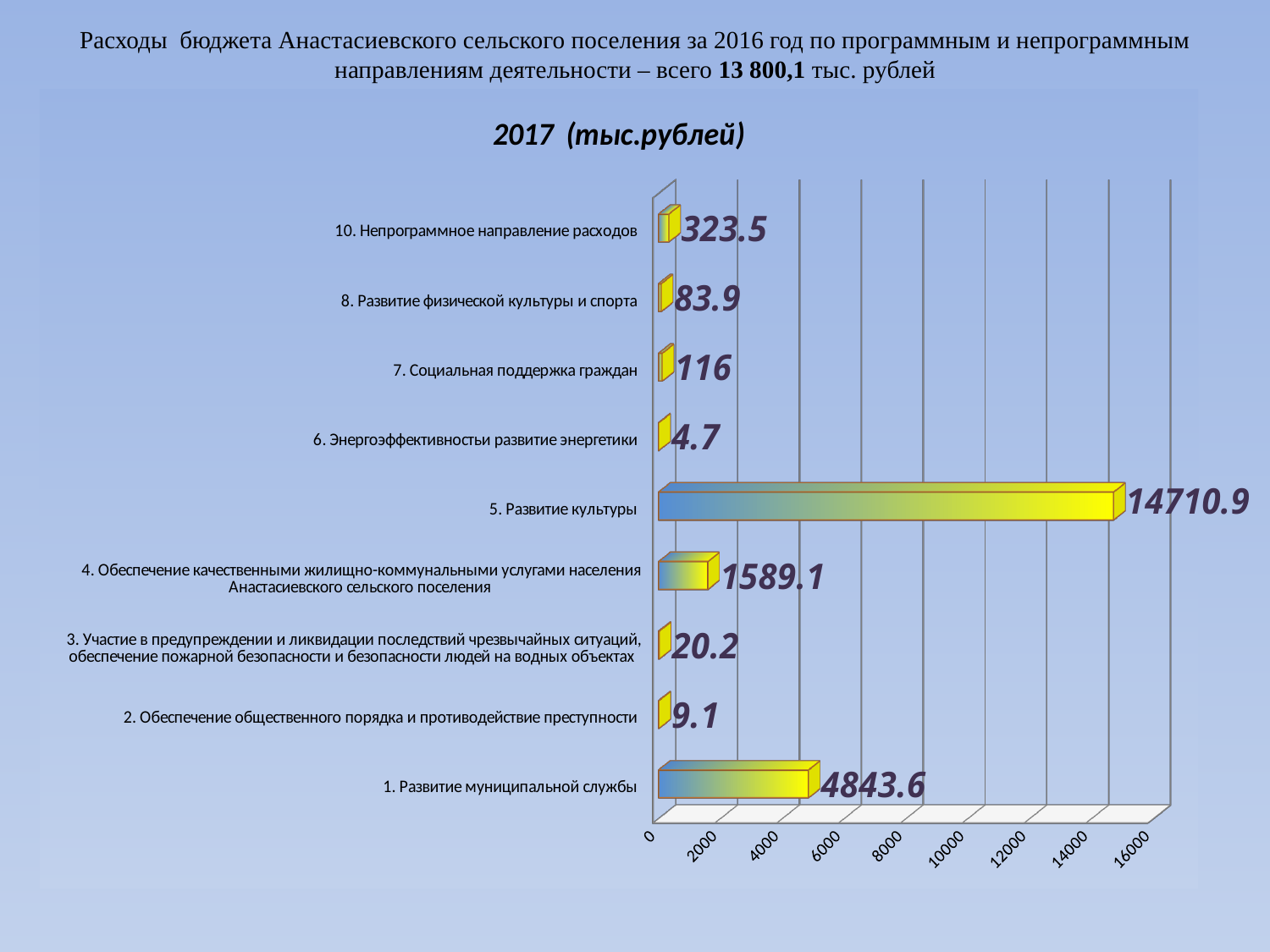
Is the value for "1. Развитие муниципальной службы" greater or less than 4000? greater Which is larger: the value for "8. Развитие физической культуры и спорта" or "7. Социальная поддержка граждан"? 7. Социальная поддержка граждан What is the value for "5. Развитие культуры"? 14710.9 Which category has the highest value? 5. Развитие культуры Which category has the lowest value? 6. Энергоэффективностьи развитие энергетики How many categories are shown in the chart? 9 What kind of chart is shown on the slide? Bar chart What is the difference between the values for "5. Развитие культуры" and "1. Развитие муниципальной службы"? 9867.3 What is the value for "1. Развитие муниципальной службы"? 4843.6 What is the value for "7. Социальная поддержка граждан"? 116 What is the value for "10. Непрограммное направление расходов"? 323.5 What is the title of the chart? 2017 (тыс.рублей)